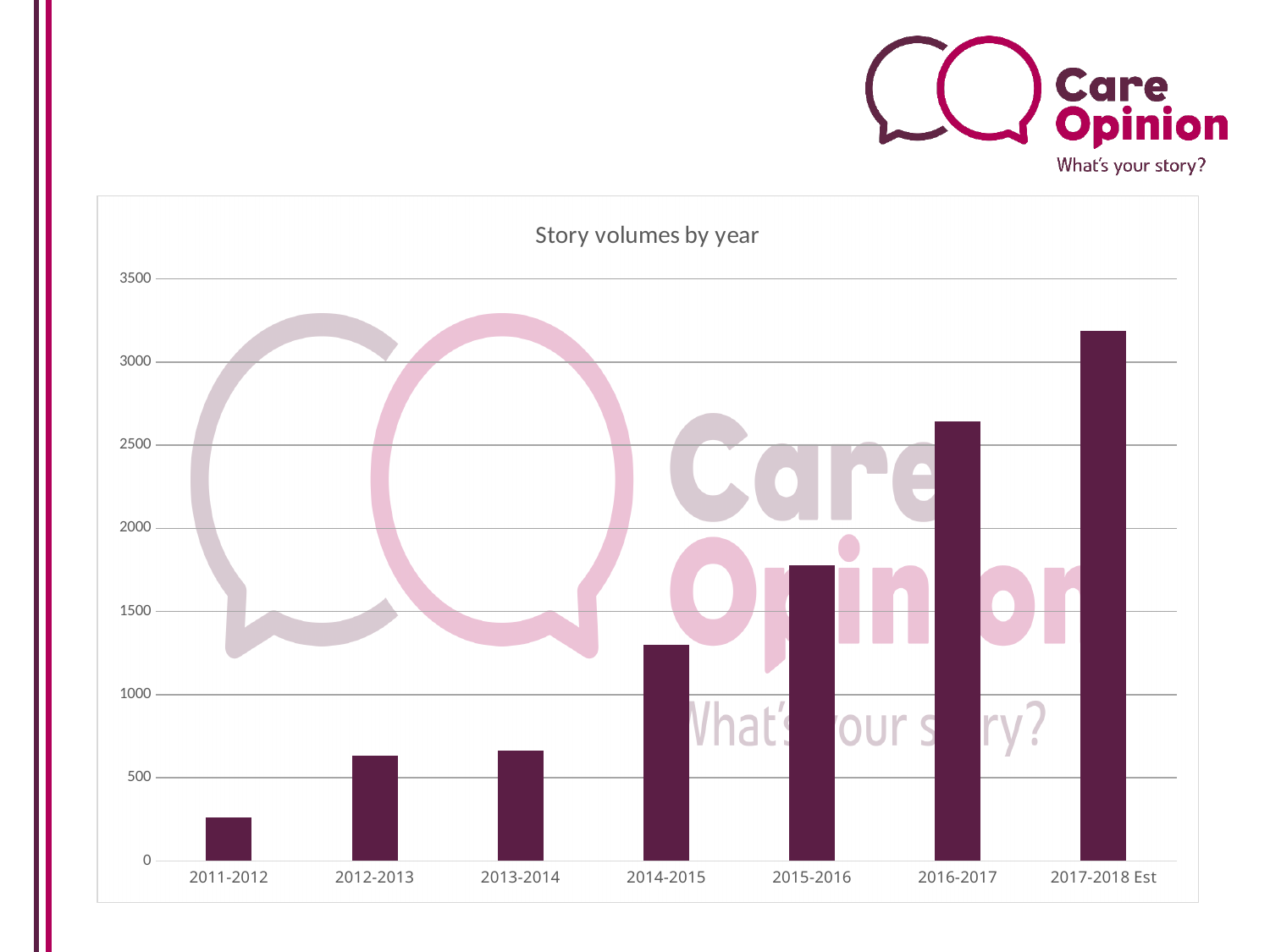
How many year categories are shown on the x axis of the chart? 7 Do the story volumes rise or fall from 2011-2012 to 2017-2018 Est? rise Which year has the lowest story volume? 2011-2012 What kind of chart is shown on the slide? bar chart Is the value for 2016-2017 greater or less than 2500? greater Is the value for 2014-2015 greater or less than 1500? less Is the value for 2015-2016 greater or less than 1500? greater Which year has the highest story volume? 2017-2018 Est What is the title of the chart? Story volumes by year Which is larger, the value for 2014-2015 or the value for 2013-2014? 2014-2015